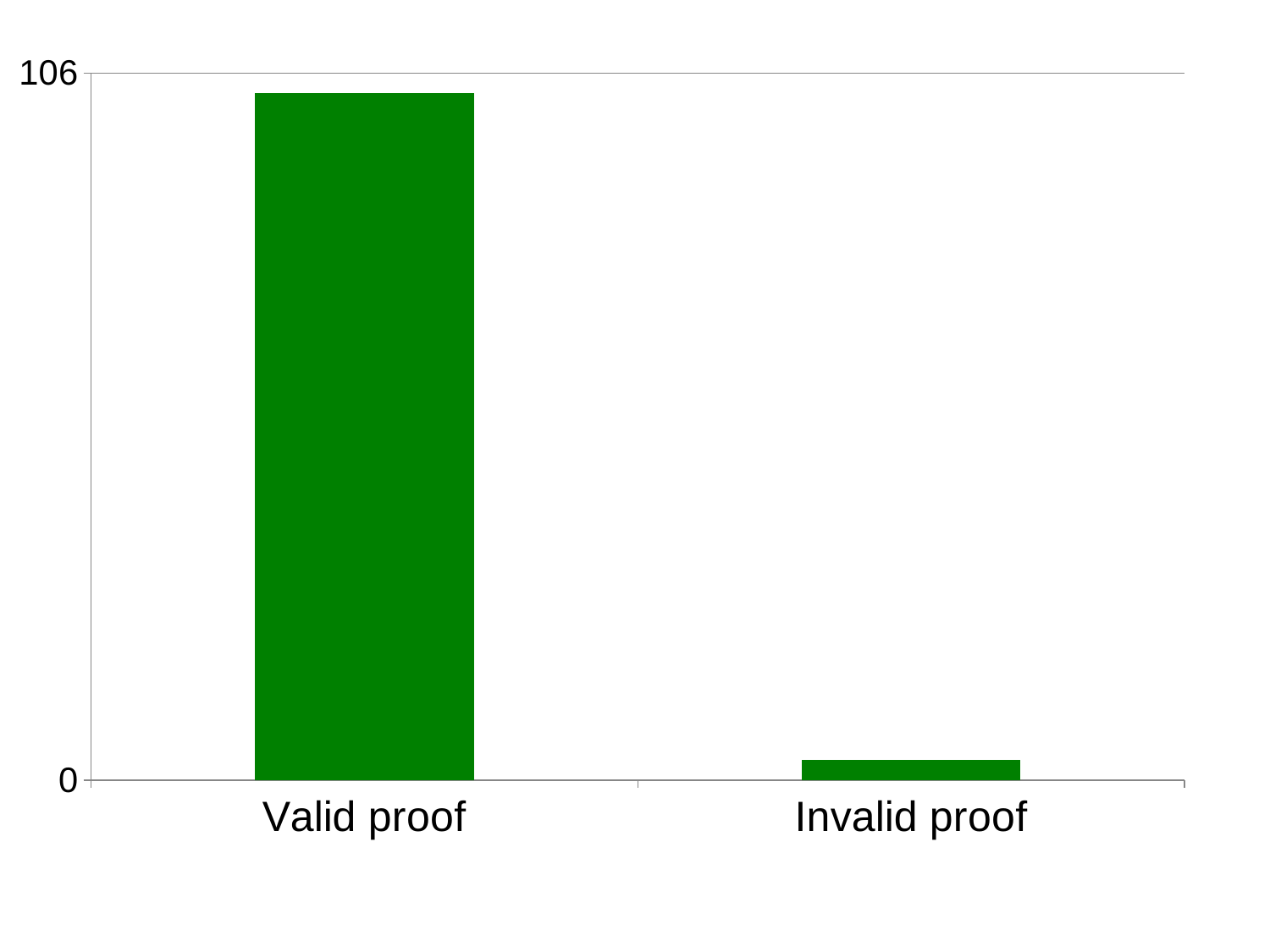
What colour are the bars on the chart? green Which category has the lowest bar? Invalid proof What is the highest value labelled on the vertical axis? 106 What kind of chart is shown on the slide? bar chart How many categories are plotted on the chart? 2 Which category has the highest bar? Valid proof Is the value for Valid proof greater or less than 0? greater Do the bar values rise or fall from left to right along the x axis? fall Is the value for Invalid proof greater or less than 106? less Which is larger, the value for Valid proof or the value for Invalid proof? Valid proof